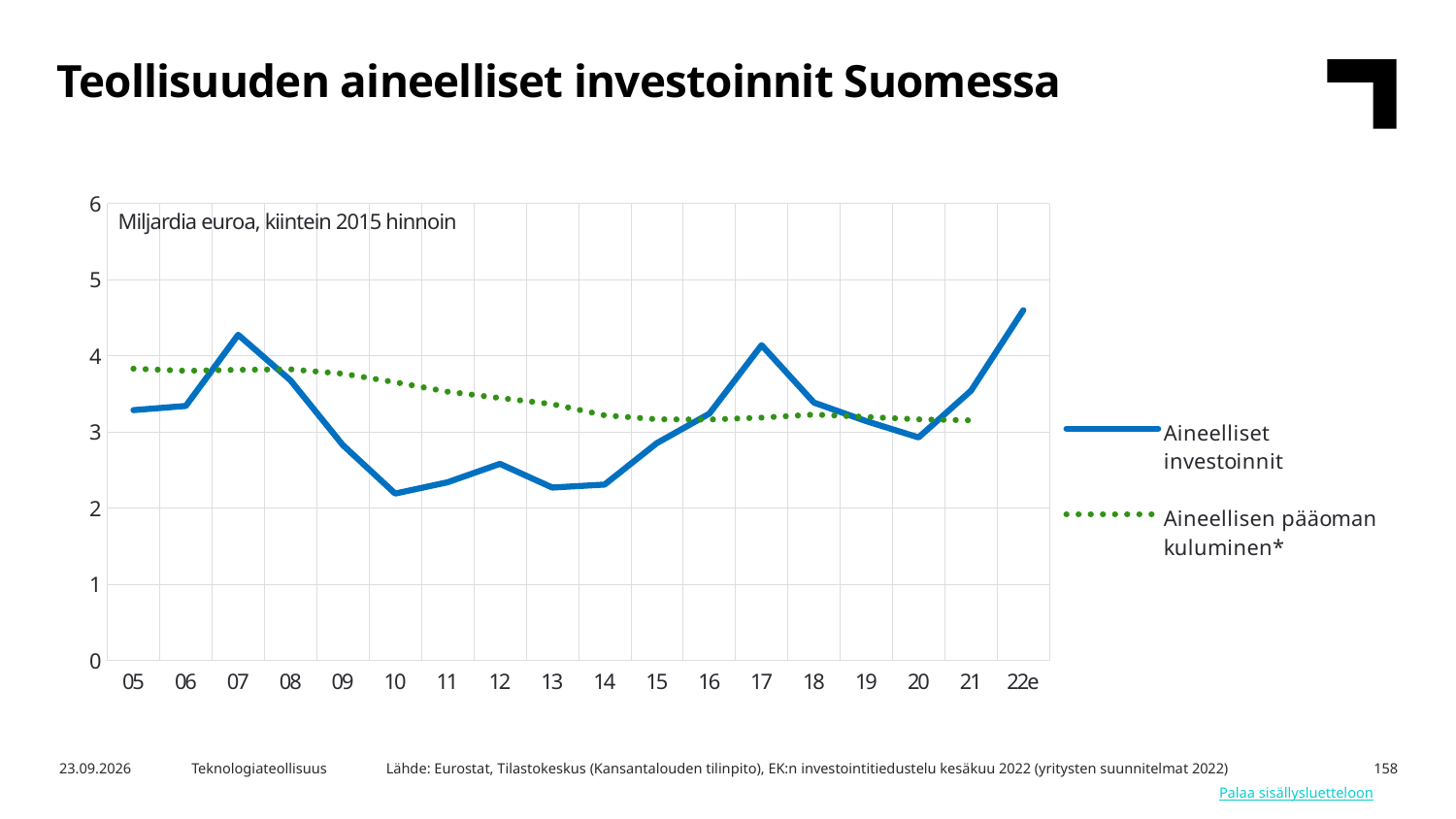
In which year does the Aineelliset investoinnit series reach its highest value? 22e Is the value of Aineelliset investoinnit in 10 greater or less than 3? less How many series does the legend list? 2 Is the value of Aineelliset investoinnit in 22e greater or less than 4? greater Which is larger in 10: Aineelliset investoinnit or Aineellisen pääoman kuluminen*? Aineellisen pääoman kuluminen* What unit is stated in the label inside the chart area? Miljardia euroa, kiintein 2015 hinnoin Does the Aineellisen pääoman kuluminen* series generally rise or fall from 05 to 21? Fall Which is larger in 17: Aineelliset investoinnit or Aineellisen pääoman kuluminen*? Aineelliset investoinnit How many years are shown on the x axis? 18 What kind of chart is shown on the slide? Line chart Is the value of Aineelliset investoinnit in 07 greater or less than 4? greater